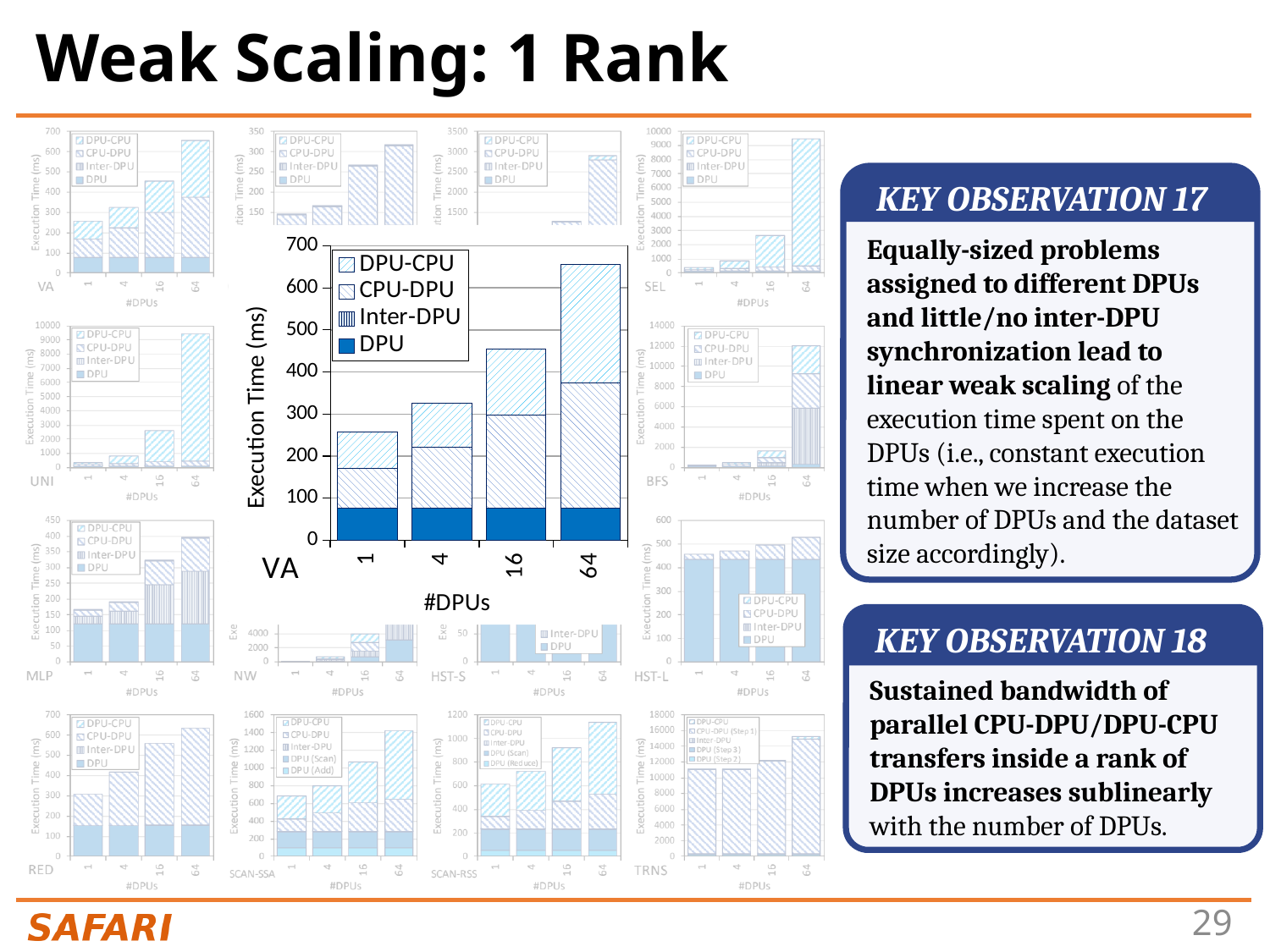
What kind of chart is the enlarged VA chart in the center of the slide? Stacked bar chart How many #DPUs categories are shown on the x axis of the enlarged VA chart? 4 How many series does the legend of the enlarged VA chart list? 4 In the enlarged VA chart, which has the larger total execution time: 4 DPUs or 64 DPUs? 64 DPUs In the enlarged VA chart, is the total execution time for 1 DPU greater or less than 300 ms? less In the enlarged VA chart, which #DPUs category has the shortest stacked bar? 1 In the enlarged VA chart, does the total execution time rise or fall as the number of DPUs increases from 1 to 64? rise In the enlarged VA chart, is the total execution time for 16 DPUs greater or less than 400 ms? greater In the enlarged VA chart, is the DPU segment for 4 DPUs greater or less than 100 ms? less What is the y-axis label of the enlarged VA chart? Execution Time (ms) In the enlarged VA chart, which #DPUs category has the tallest stacked bar? 64